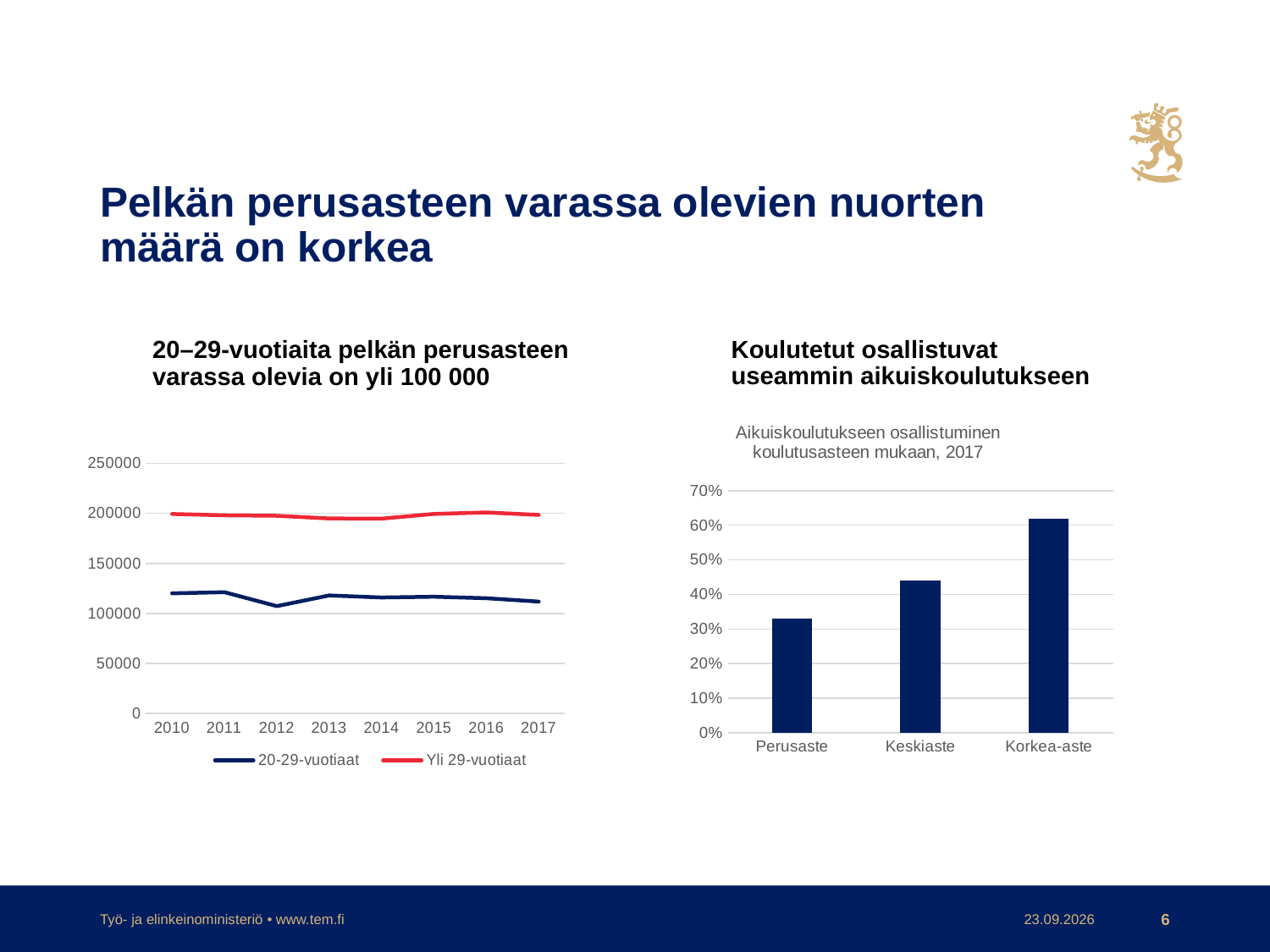
In the right chart 'Aikuiskoulutukseen osallistuminen koulutusasteen mukaan, 2017', is the value for Perusaste greater or less than 40%? less What kind of chart is the chart on the left of the slide? line chart In the right chart 'Aikuiskoulutukseen osallistuminen koulutusasteen mukaan, 2017', which category has the lowest value? Perusaste In the left line chart, is the value for '20-29-vuotiaat' in 2017 greater or less than 100000? greater How many series does the legend of the left line chart list? 2 In the right chart 'Aikuiskoulutukseen osallistuminen koulutusasteen mukaan, 2017', is the value for Korkea-aste greater or less than 60%? greater What kind of chart is the chart on the right, titled 'Aikuiskoulutukseen osallistuminen koulutusasteen mukaan, 2017'? bar chart In the left line chart, which series has higher values, '20-29-vuotiaat' or 'Yli 29-vuotiaat'? Yli 29-vuotiaat How many categories are shown in the right chart 'Aikuiskoulutukseen osallistuminen koulutusasteen mukaan, 2017'? 3 How many years are shown on the x axis of the left line chart? 8 In the right chart 'Aikuiskoulutukseen osallistuminen koulutusasteen mukaan, 2017', which category has the highest value? Korkea-aste